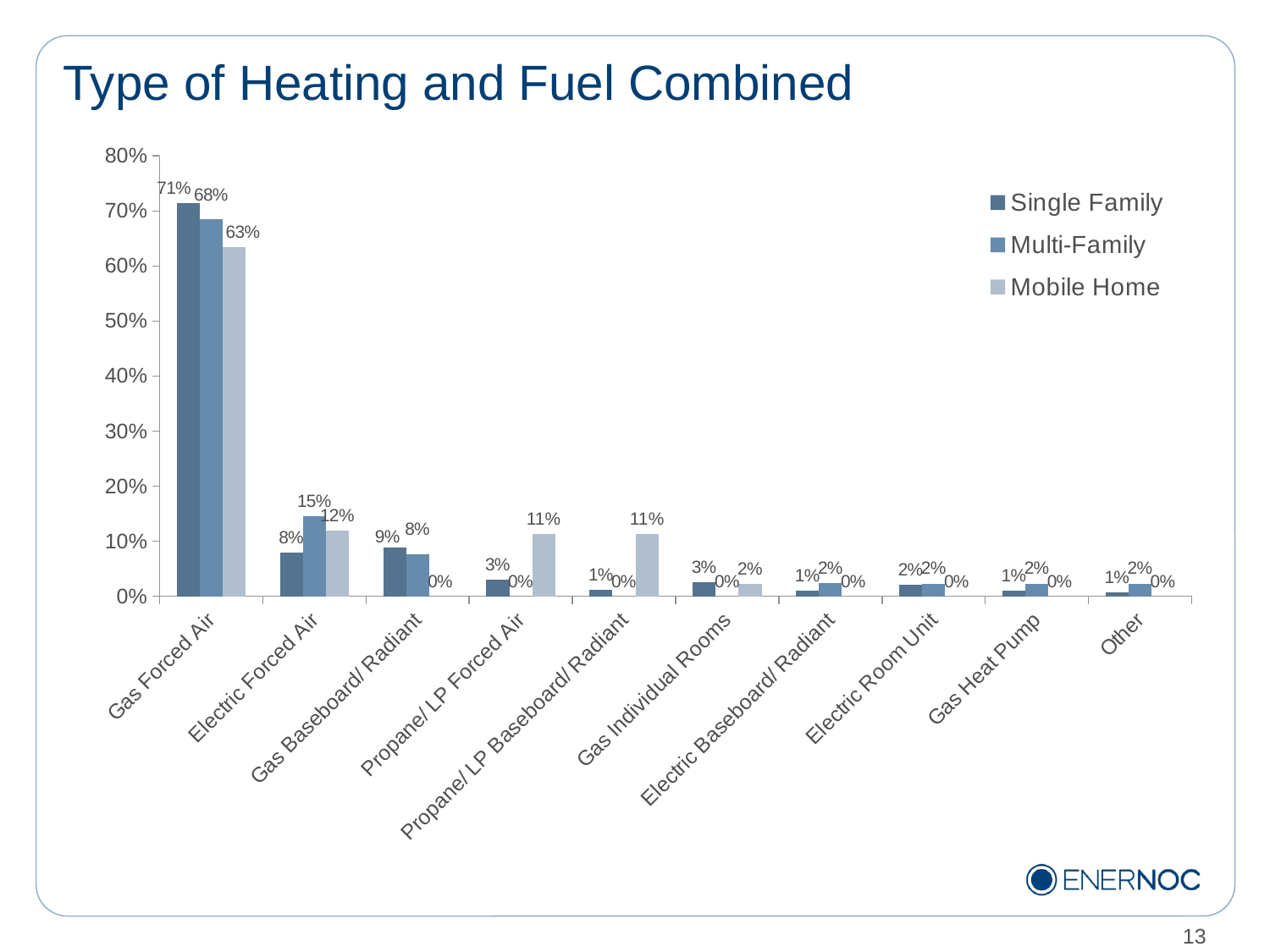
What is the title of the chart? Type of Heating and Fuel Combined Which is larger for Electric Forced Air: the Single Family value or the Multi-Family value? Multi-Family What kind of chart is shown on the slide? Bar chart How many series does the legend list? 3 Is the Multi-Family value for Gas Forced Air greater or less than 60%? greater What is the Multi-Family value for Electric Forced Air? 15% Which category has the highest Mobile Home value? Gas Forced Air What is the Mobile Home value for Gas Baseboard/ Radiant? 0% What is the difference between the Single Family and Mobile Home values for Gas Forced Air? 8% What is the Single Family value for Gas Forced Air? 71% How many heating type categories are shown on the x axis? 10 What is the Mobile Home value for Propane/ LP Forced Air? 11%